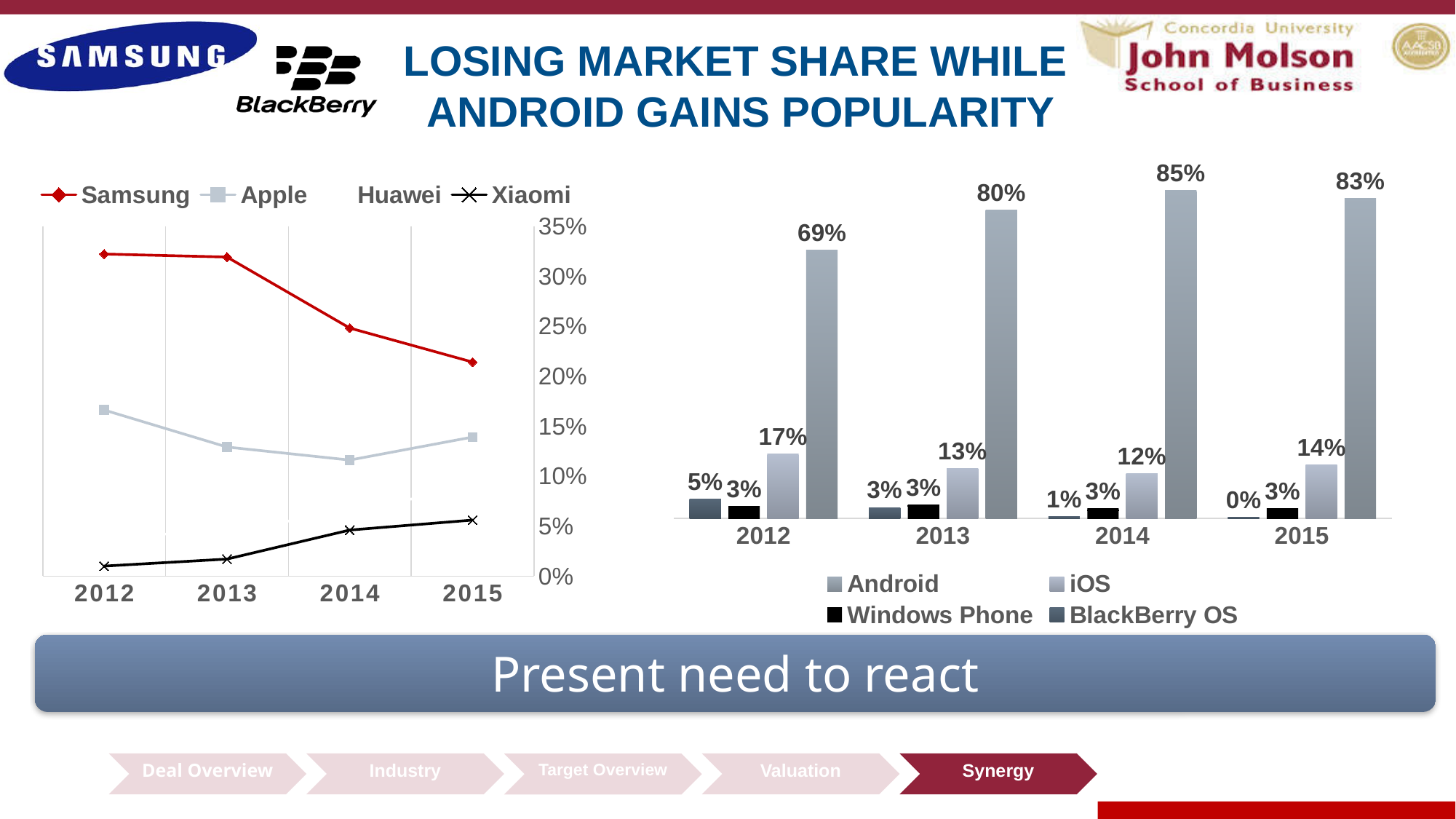
In the line chart on the left, is the value for Samsung in 2012 greater or less than 30%? greater In the bar chart on the right, what is the value for Android in 2014? 85% In the bar chart on the right, what is the difference between the Android value in 2015 and in 2012? 14% In the line chart on the left, does the Samsung line rise or fall from 2012 to 2015? Fall In the bar chart on the right, which is larger in 2013: iOS or Windows Phone? iOS In the bar chart on the right, in which year is the Android value highest? 2014 What kind of chart is the chart on the left of the slide? Line chart In the line chart on the left, is the value for Xiaomi in 2015 greater or less than 10%? less In the bar chart on the right, what is the value for BlackBerry OS in 2015? 0% In the bar chart on the right, what is the value for iOS in 2012? 17% How many years are shown on the x axis of the line chart on the left? 4 How many series does the legend of the bar chart on the right list? 4